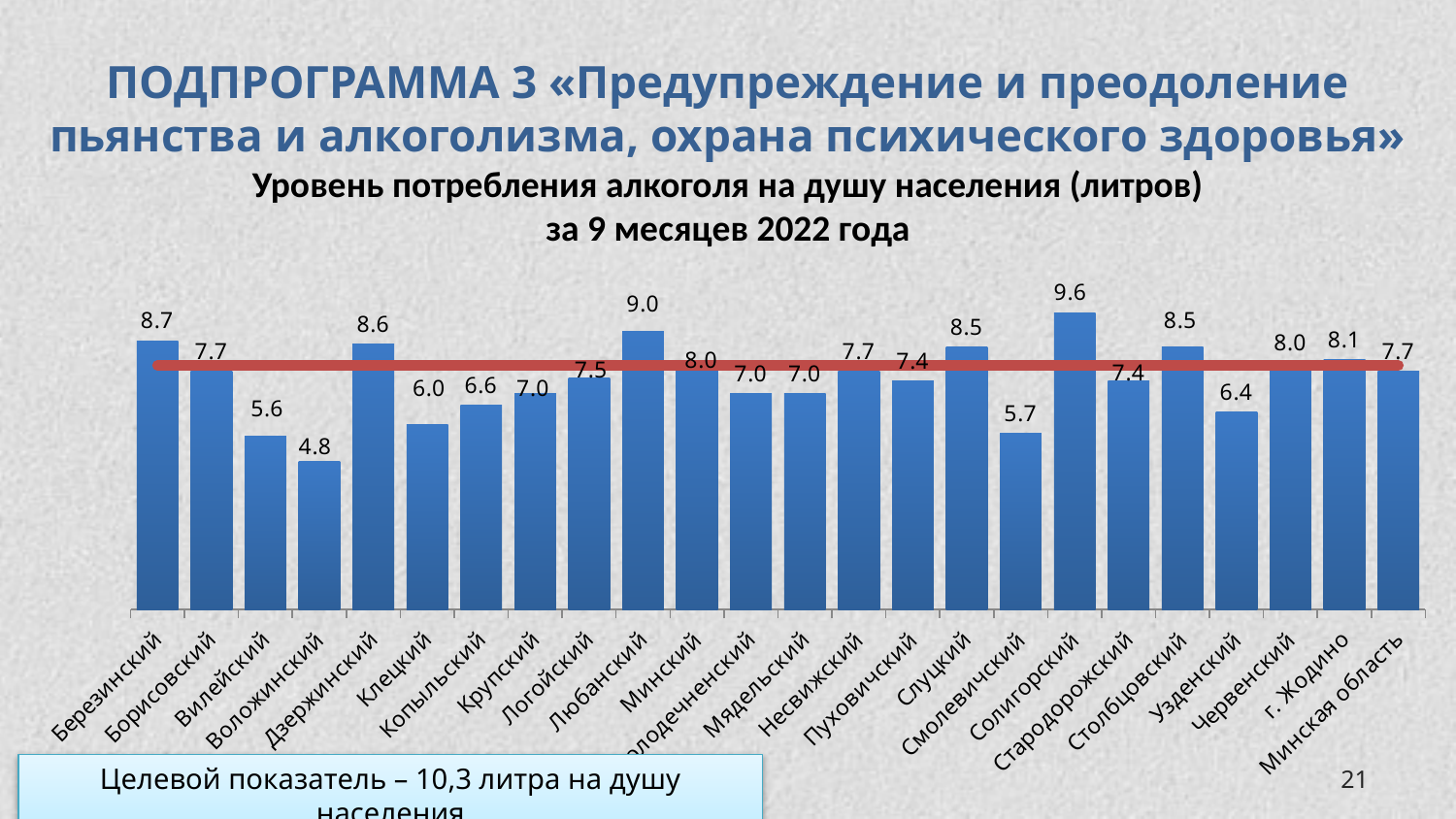
How many districts/categories are shown on the chart? 24 What kind of chart is shown on the slide? Combination bar and line chart (bars with a horizontal line) Which district has the lowest alcohol consumption per capita? Воложинский What is the difference between the values for Солигорский and Воложинский? 4.8 What is the value shown for Минская область? 7.7 Which is larger, the value for Вилейский or the value for Узденский? Узденский What is the difference between the values for Березинский and Дзержинский? 0.1 What is the value shown for Воложинский? 4.8 What is the alcohol consumption value for Солигорский? 9.6 What is the value shown for г. Жодино? 8.1 Which is larger, the value for Любанский or the value for Слуцкий? Любанский Which district has the highest alcohol consumption per capita? Солигорский